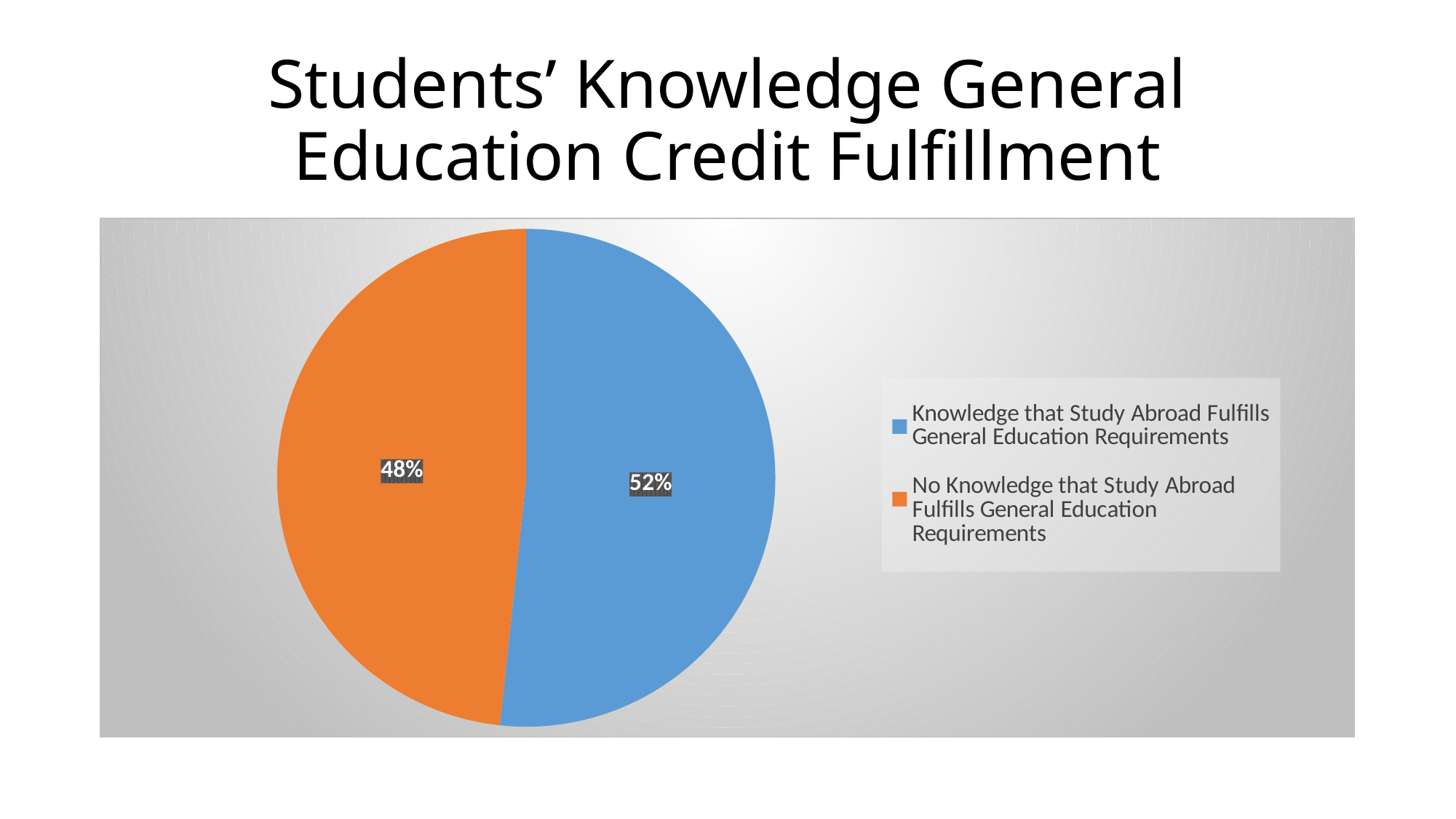
Which is larger: the share of students with knowledge that study abroad fulfills general education requirements, or the share with no knowledge? Knowledge that Study Abroad Fulfills General Education Requirements How many slices does the pie chart have? 2 What percentage of students have knowledge that study abroad fulfills general education requirements? 52% What is the difference in percentage points between the 'Knowledge' slice and the 'No Knowledge' slice? 4 Is the share of students with no knowledge that study abroad fulfills general education requirements greater or less than 50%? less What colour is the slice for 'No Knowledge that Study Abroad Fulfills General Education Requirements'? orange How many entries does the legend list? 2 What is the title of the slide? Students' Knowledge General Education Credit Fulfillment Which slice is the largest in the pie chart? Knowledge that Study Abroad Fulfills General Education Requirements What kind of chart is shown on the slide? pie chart What percentage of students have no knowledge that study abroad fulfills general education requirements? 48% Which slice is the smallest in the pie chart? No Knowledge that Study Abroad Fulfills General Education Requirements